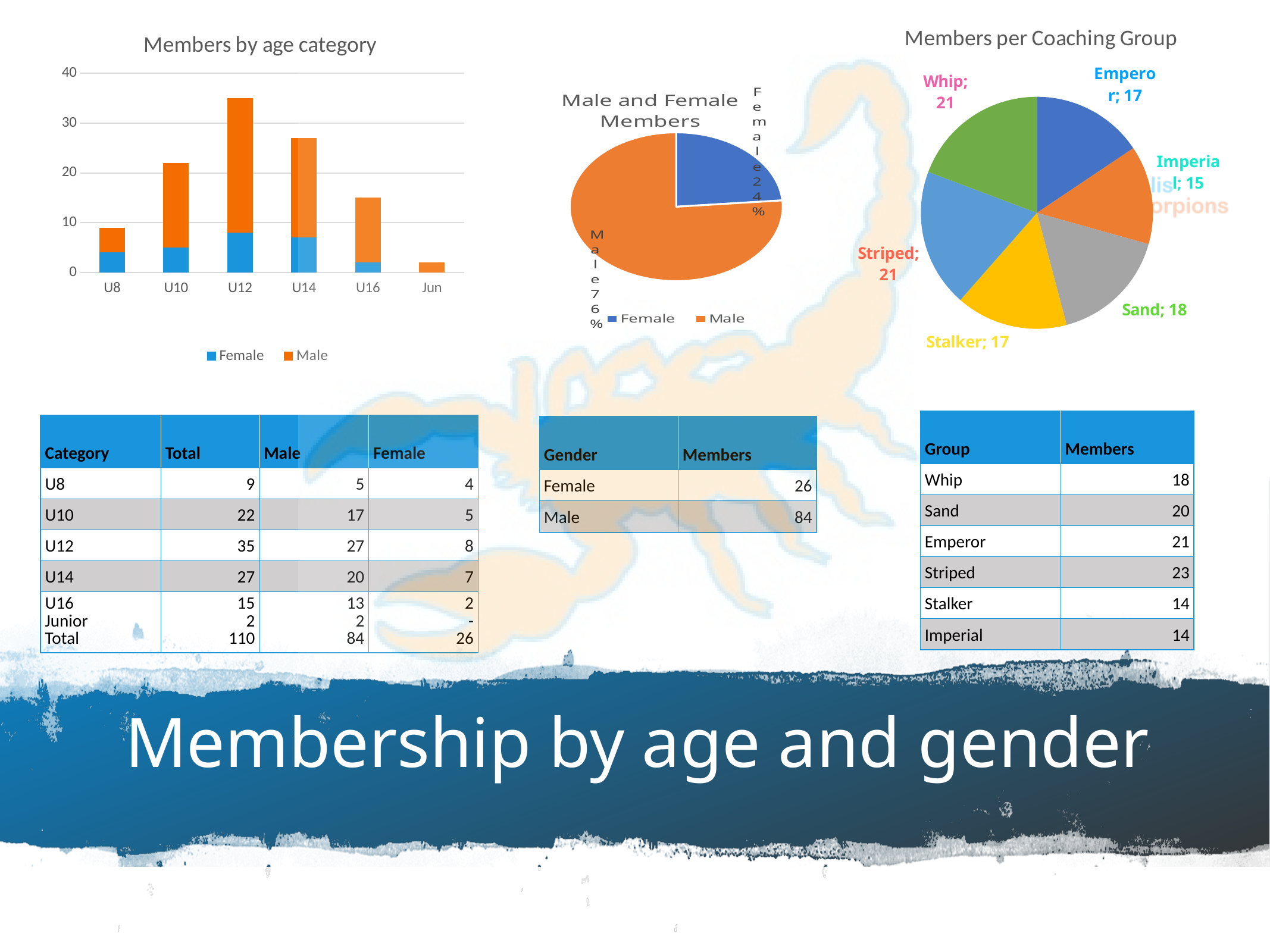
In the 'Members per Coaching Group' pie chart, what is the difference between the Whip and Imperial member counts? 6 In the 'Members by age category' chart, is the total bar for U12 greater or less than 30? greater In the 'Members by age category' chart, is the total bar for U16 greater or less than 20? less In the 'Members per Coaching Group' pie chart, how many members does the Sand group have? 18 In the 'Members by age category' chart, which age category has the shortest bar? Jun In the 'Male and Female Members' pie chart, what percentage of members are male? 76% What kind of chart is 'Members by age category'? Bar chart In the 'Male and Female Members' pie chart, what percentage of members are female? 24% In the 'Members by age category' chart, which age category has the tallest bar? U12 How many series does the legend of the 'Members by age category' chart list? 2 In the 'Members per Coaching Group' pie chart, which group has the fewest members? Imperial How many age categories are shown on the x axis of the 'Members by age category' chart? 6